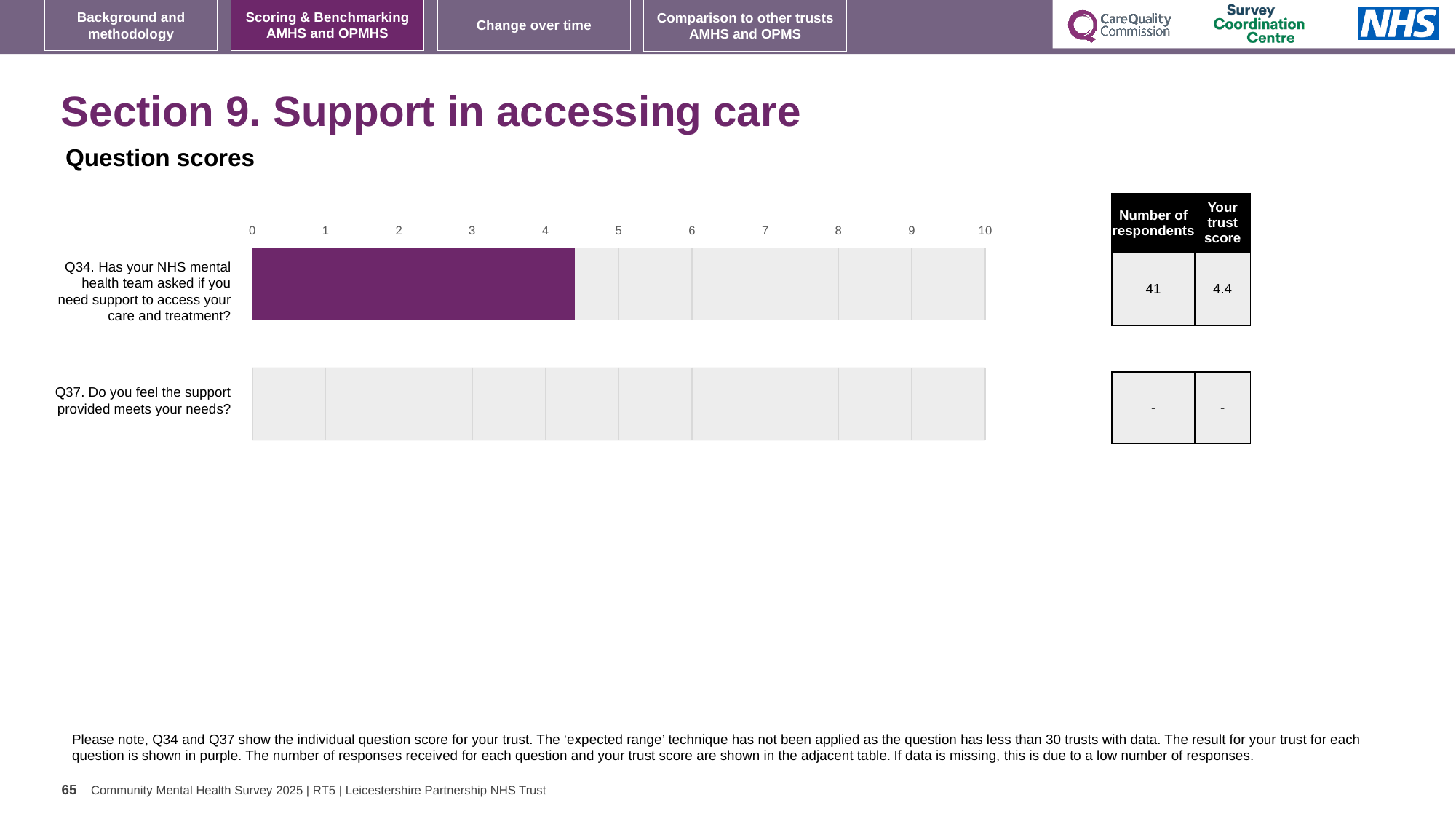
What kind of chart is used to show the question scores? Bar chart What colour is the bar showing the trust's score for Q34? Purple Is the score for Q34 greater or less than 5? less How many respondents answered Q34? 41 What is shown as the trust score for Q37 (Do you feel the support provided meets your needs?)? - Is the score for Q34 greater or less than 4? greater What is shown as the number of respondents for Q37? - How many questions are listed in the chart? 2 What is the maximum value shown on the chart's axis? 10 What is the trust score for Q34 (Has your NHS mental health team asked if you need support to access your care and treatment?)? 4.4